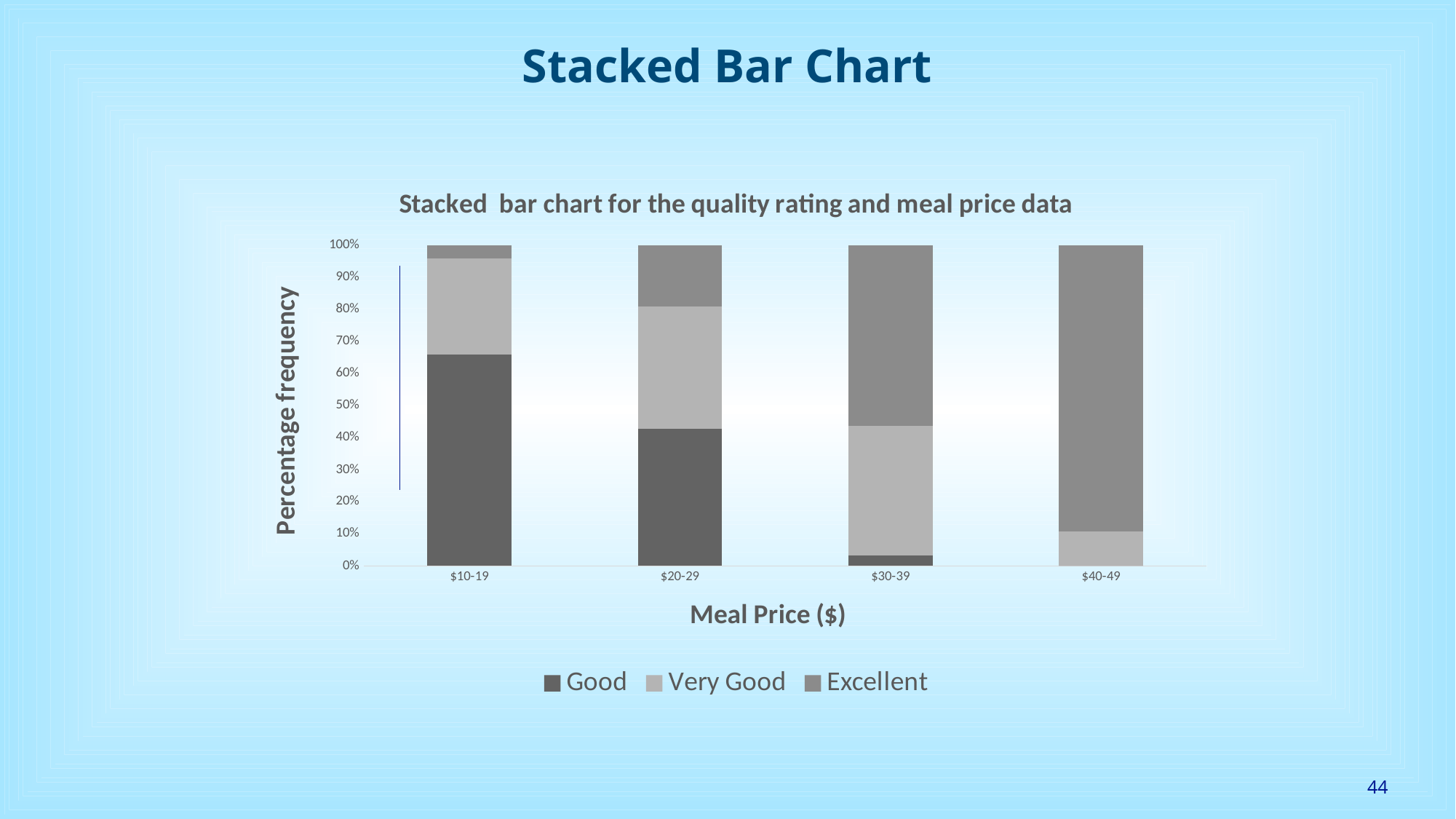
Which meal price category has the largest Good segment? $10-19 Is the Good share for the $30-39 category greater or less than 10%? less What is the label of the x axis? Meal Price ($) What is the total height of each stacked bar? 100% What is the title of the chart? Stacked bar chart for the quality rating and meal price data Does the Excellent share rise or fall as meal price increases from $10-19 to $40-49? Rises How many series does the legend list? 3 What kind of chart is shown on the slide? Stacked bar chart Is the Good share for the $10-19 category greater or less than 60%? greater Which is larger, the Good segment for $20-29 or the Good segment for $30-39? $20-29 How many meal price categories are shown on the x axis? 4 Which meal price category has the largest Excellent segment? $40-49